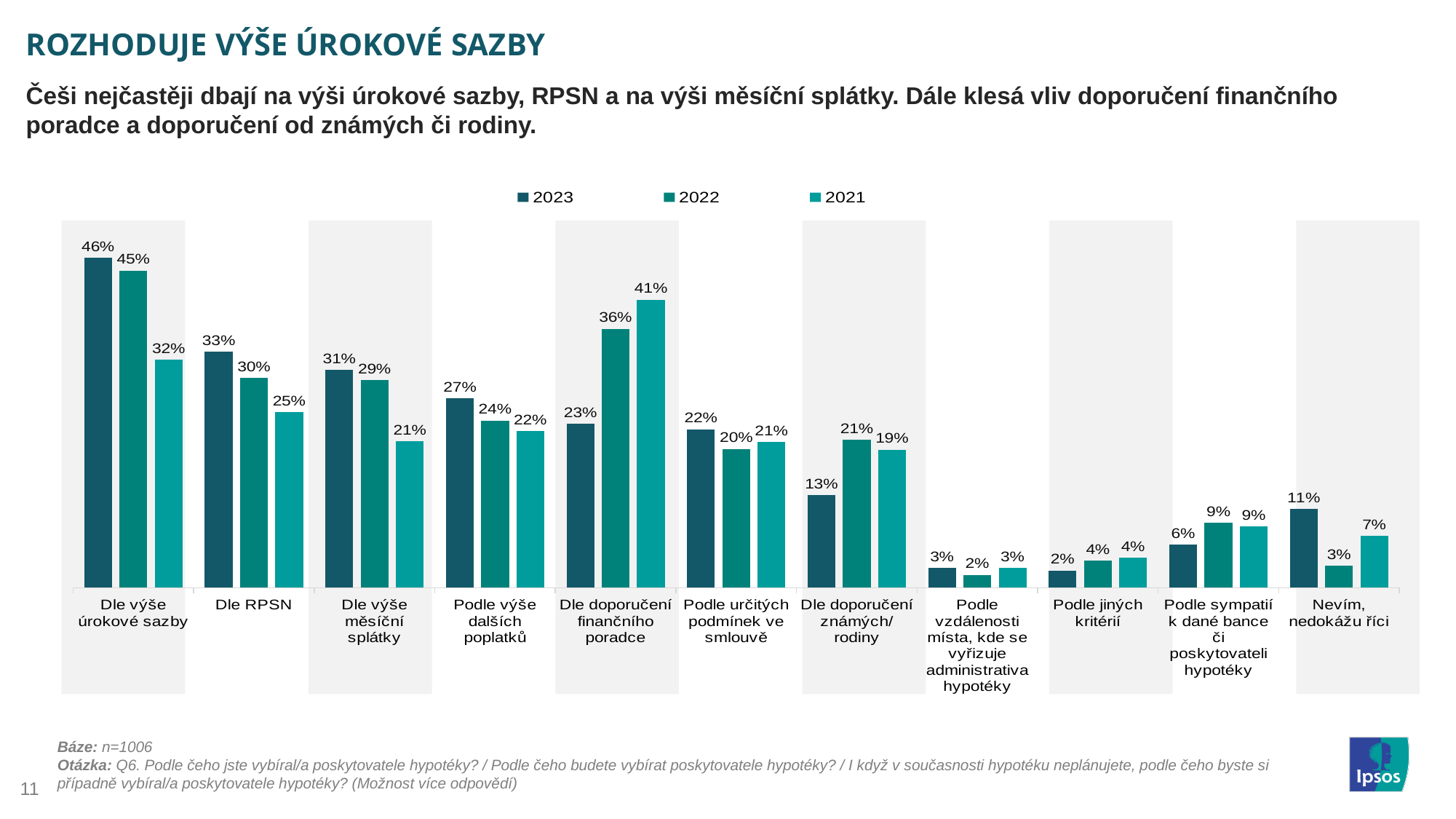
How many categories are shown on the x axis? 11 How many series does the legend list? 3 Which category has the lowest 2023 value? Podle jiných kritérií For "Nevím, nedokážu říci", which year has the larger value, 2023 or 2021? 2023 What kind of chart is shown on the slide? Bar chart Which category has the highest 2023 value? Dle výše úrokové sazby What is the difference between the 2021 and 2023 values for "Dle doporučení finančního poradce"? 18 percentage points What is the difference between the 2023 and 2022 values for "Dle RPSN"? 3 percentage points Which years are listed in the legend? 2023, 2022, 2021 What is the 2021 value for "Dle doporučení finančního poradce"? 41% What is the 2023 value for "Dle výše úrokové sazby"? 46% What is the 2022 value for "Dle doporučení známých/ rodiny"? 21%